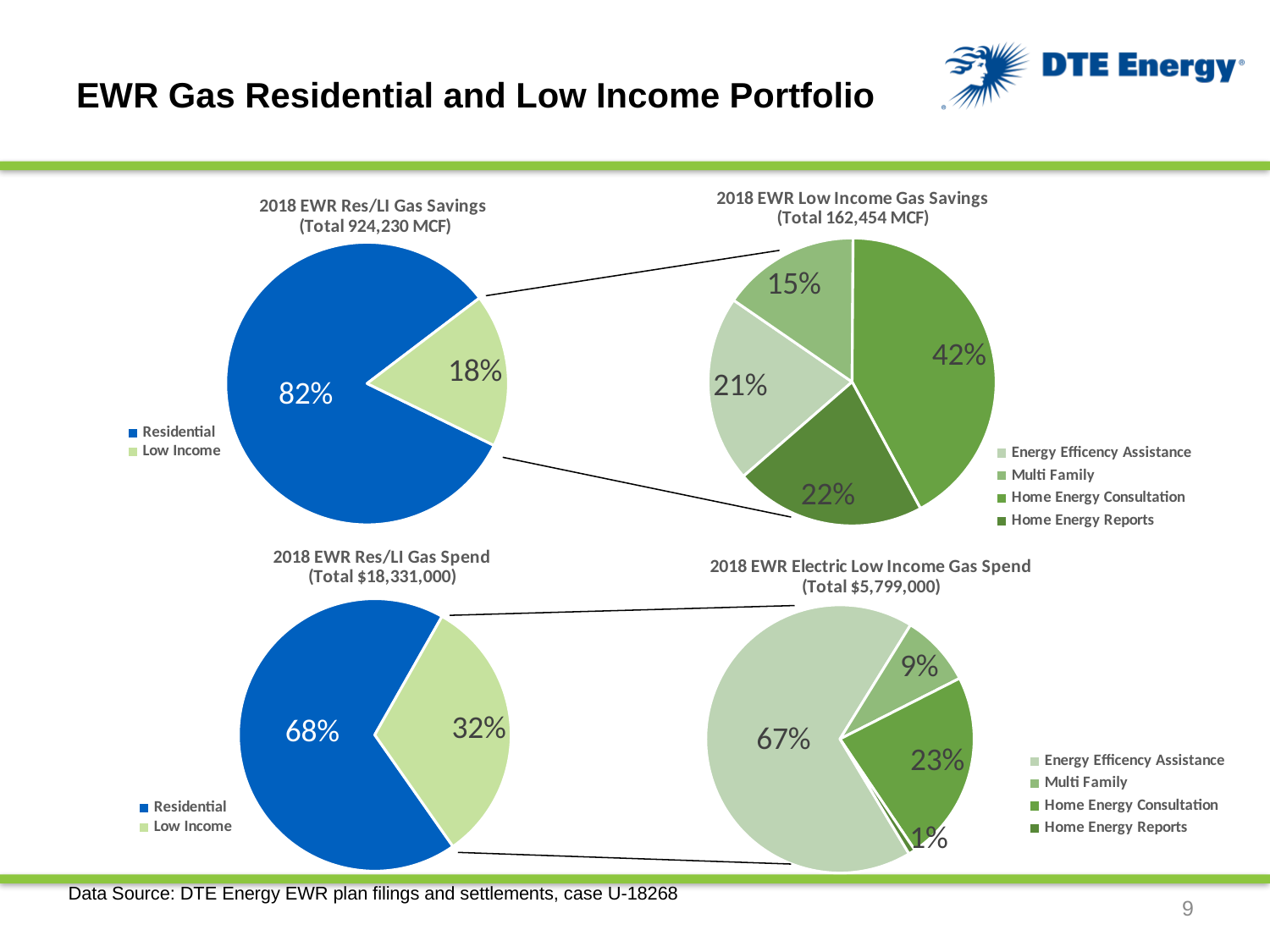
How many slices does the '2018 EWR Electric Low Income Gas Spend' pie chart have? 4 In the '2018 EWR Res/LI Gas Savings' pie chart, what share is Low Income? 18% In the '2018 EWR Res/LI Gas Spend' pie chart, what share is Low Income? 32% In the '2018 EWR Low Income Gas Savings' pie chart, what is the largest slice's share? 42% What total is stated in the title of the '2018 EWR Low Income Gas Savings' chart? 162,454 MCF In the '2018 EWR Low Income Gas Savings' pie chart, which category has the smallest share? Multi Family In the '2018 EWR Electric Low Income Gas Spend' pie chart, what share is Home Energy Reports? 1% In the '2018 EWR Res/LI Gas Spend' pie chart, which is larger, Residential or Low Income? Residential In the '2018 EWR Low Income Gas Savings' pie chart, what is the difference between the Home Energy Consultation share and the Home Energy Reports share? 20 percentage points In the '2018 EWR Res/LI Gas Savings' pie chart, what share is Residential? 82% What type of chart is used for '2018 EWR Res/LI Gas Savings'? Pie chart In the '2018 EWR Electric Low Income Gas Spend' pie chart, what share is Energy Efficiency Assistance? 67%